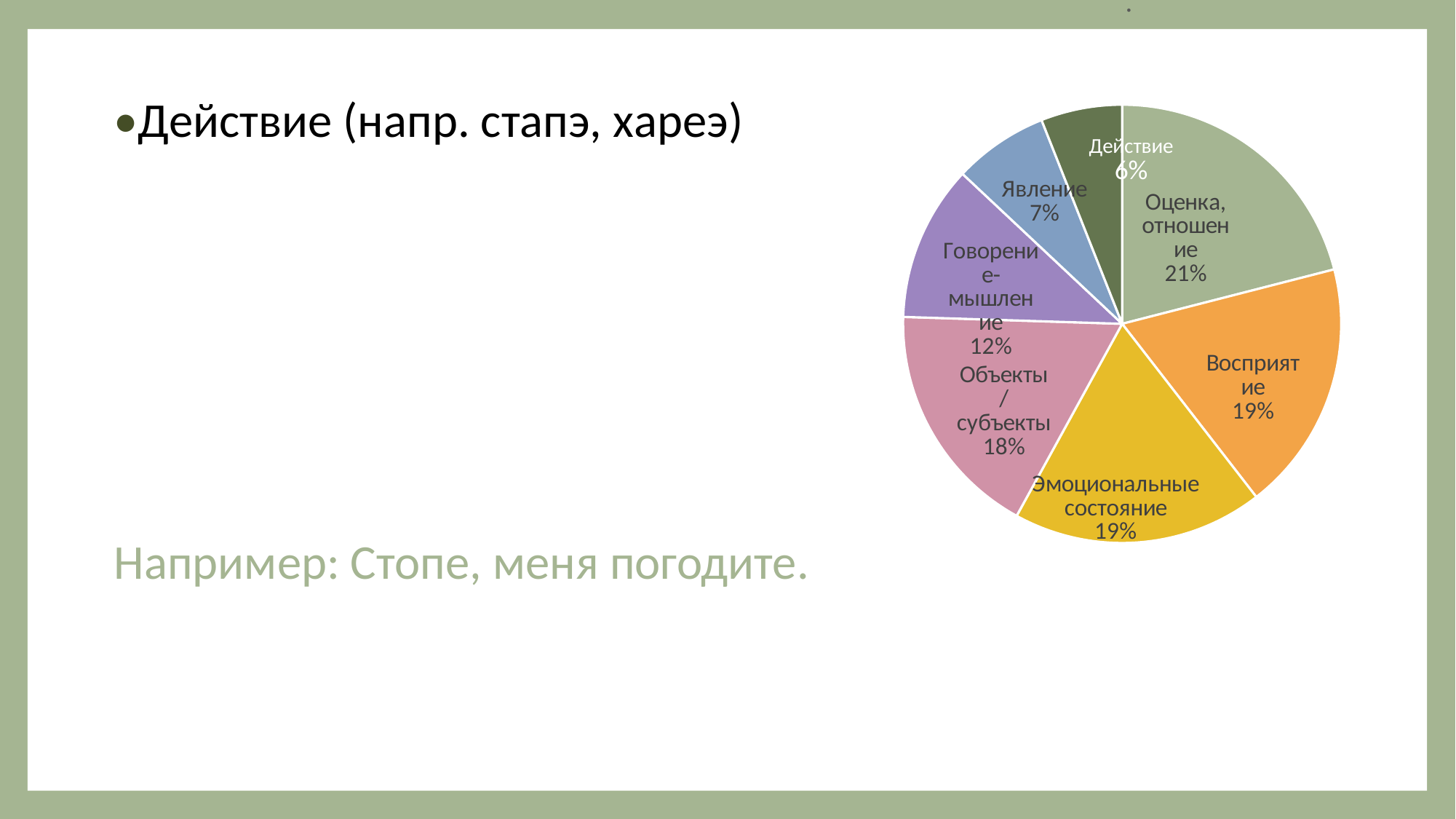
What share of the pie does the slice "Оценка, отношение" have? 21% What share of the pie does the slice "Явление" have? 7% What share of the pie does the slice "Восприятие" have? 19% Which slice of the pie chart is the smallest? Действие Which slice is larger, "Объекты / субъекты" or "Явление"? Объекты / субъекты What is the difference in percentage points between "Оценка, отношение" and "Говорение-мышление"? 9 What kind of chart is shown on the slide? pie chart How many slices does the pie chart have? 7 Which slice of the pie chart is the largest? Оценка, отношение